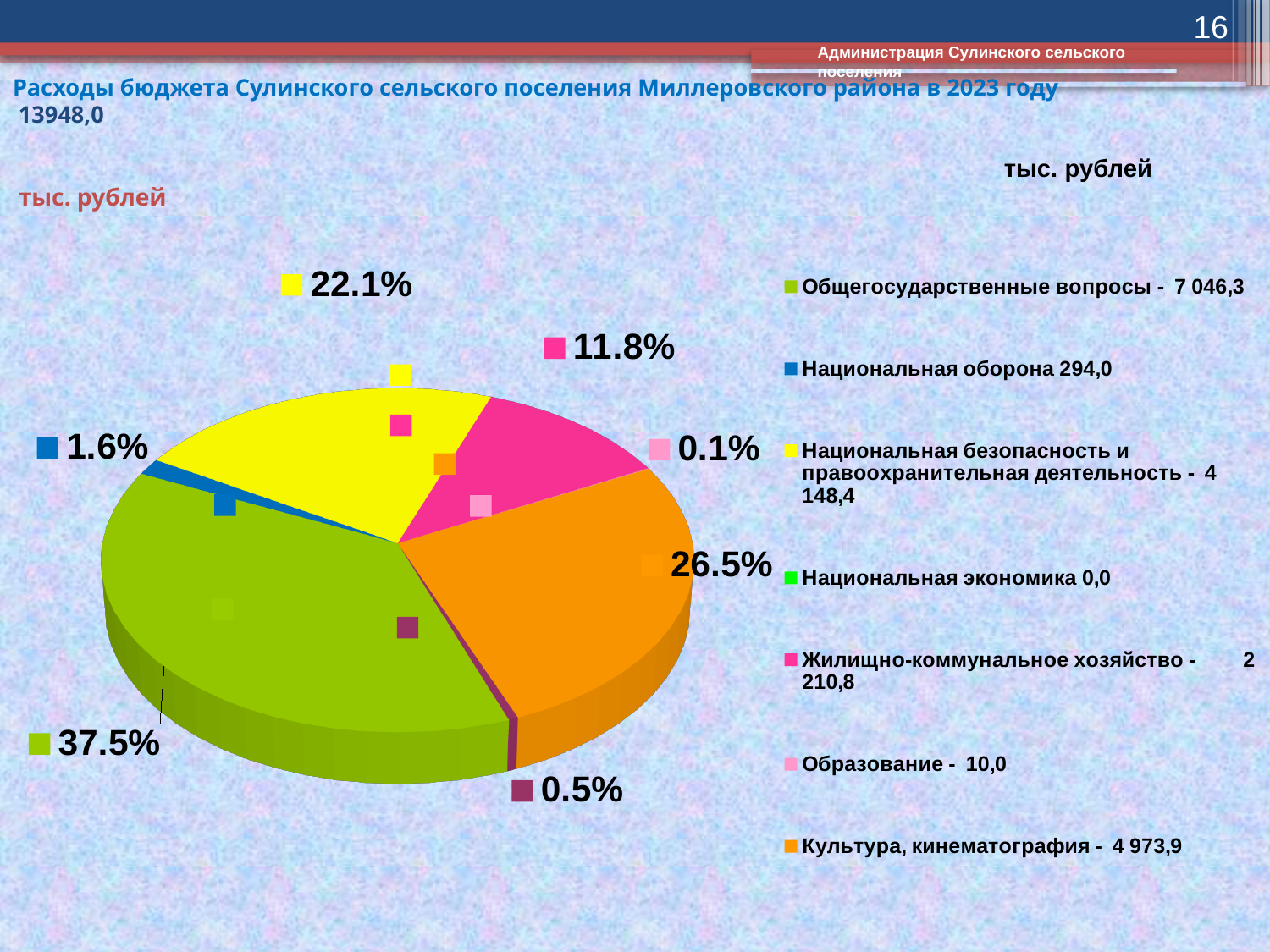
Which category has the largest slice of the pie? Общегосударственные вопросы Which category has the smallest labelled slice of the pie? Образование What amount in thousand rubles is shown in the legend for Культура, кинематография? 4 973,9 What percentage share does the slice for Общегосударственные вопросы have? 37.5% What percentage share does the slice for Жилищно-коммунальное хозяйство have? 11.8% What kind of chart is shown on the slide? Pie chart Which slice is larger: Культура, кинематография or Жилищно-коммунальное хозяйство? Культура, кинематография How many entries does the legend list? 7 What percentage share does the slice for Культура, кинематография have? 26.5% What is the difference in percentage points between the Общегосударственные вопросы slice and the Культура, кинематография slice? 11.0 What percentage share does the slice for Национальная безопасность и правоохранительная деятельность have? 22.1% What percentage share does the slice for Национальная оборона have? 1.6%